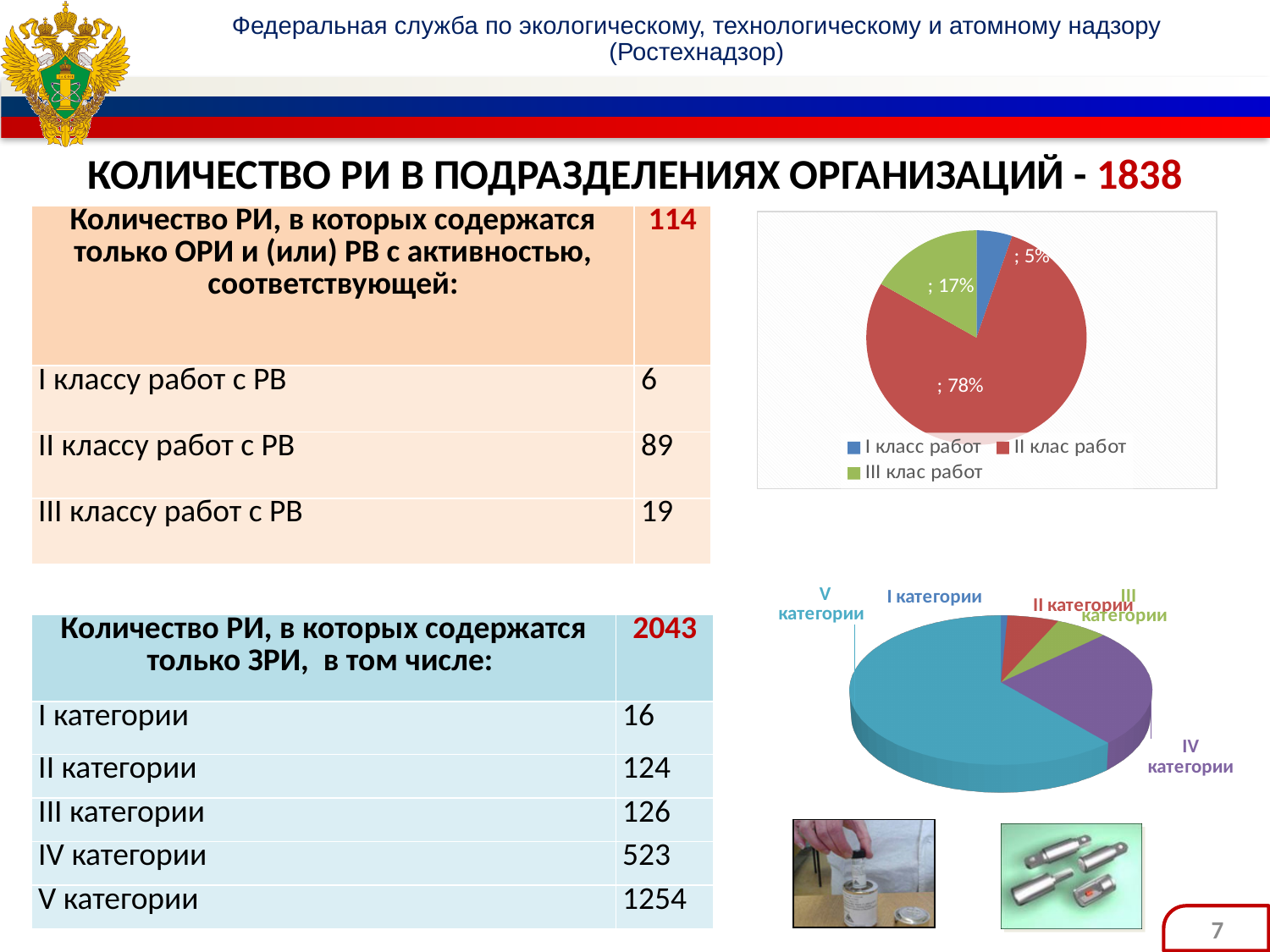
In the top pie chart, what percentage share is shown for II клас работ? 78% In the bottom pie chart, which slice is larger: IV категории or II категории? IV категории How many entries does the legend of the top pie chart list? 3 In the top pie chart, what percentage share is shown for I класс работ? 5% In the bottom pie chart, which category has the largest slice? V категории In the top pie chart, which slice is larger: III клас работ or I класс работ? III клас работ In the top pie chart, which category has the smallest slice? I класс работ In the top pie chart, what is the difference in percentage points between the II клас работ slice and the III клас работ slice? 61 In the top pie chart, what percentage share is shown for III клас работ? 17% In the top pie chart, which category has the largest slice? II клас работ How many categories are shown in the bottom pie chart? 5 What type of chart is shown at the top right of the slide? Pie chart